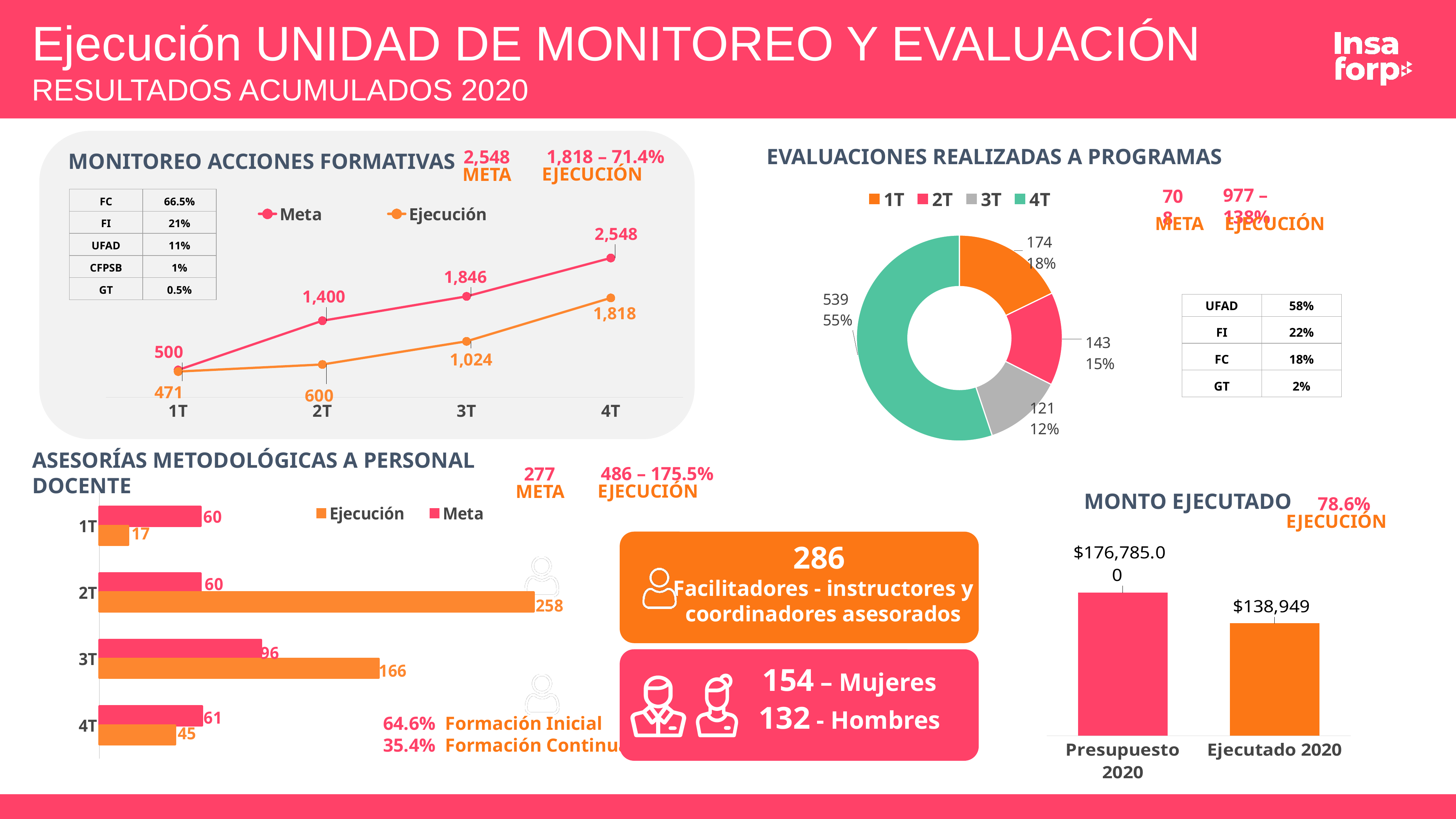
In the MONITOREO ACCIONES FORMATIVAS chart, what is the Ejecución value for 2T? 600 What kind of chart is the MONITOREO ACCIONES FORMATIVAS chart? line chart In the EVALUACIONES REALIZADAS A PROGRAMAS chart, which quarter has the largest share? 4T In the ASESORÍAS METODOLÓGICAS A PERSONAL DOCENTE chart, which is larger for 1T, Meta or Ejecución? Meta In the ASESORÍAS METODOLÓGICAS A PERSONAL DOCENTE chart, what is the Ejecución value for 2T? 258 In the MONITOREO ACCIONES FORMATIVAS chart, do the Meta values rise or fall from 1T to 4T? rise In the MONITOREO ACCIONES FORMATIVAS chart, what is the Meta value for 3T? 1,846 How many series does the legend of the EVALUACIONES REALIZADAS A PROGRAMAS chart list? 4 In the MONITOREO ACCIONES FORMATIVAS chart, what is the difference between Meta and Ejecución at 4T? 730 In the EVALUACIONES REALIZADAS A PROGRAMAS chart, what is the value for 3T? 121 In the EVALUACIONES REALIZADAS A PROGRAMAS chart, what share does 2T represent? 15% In the MONTO EJECUTADO chart, what is the value for Ejecutado 2020? $138,949